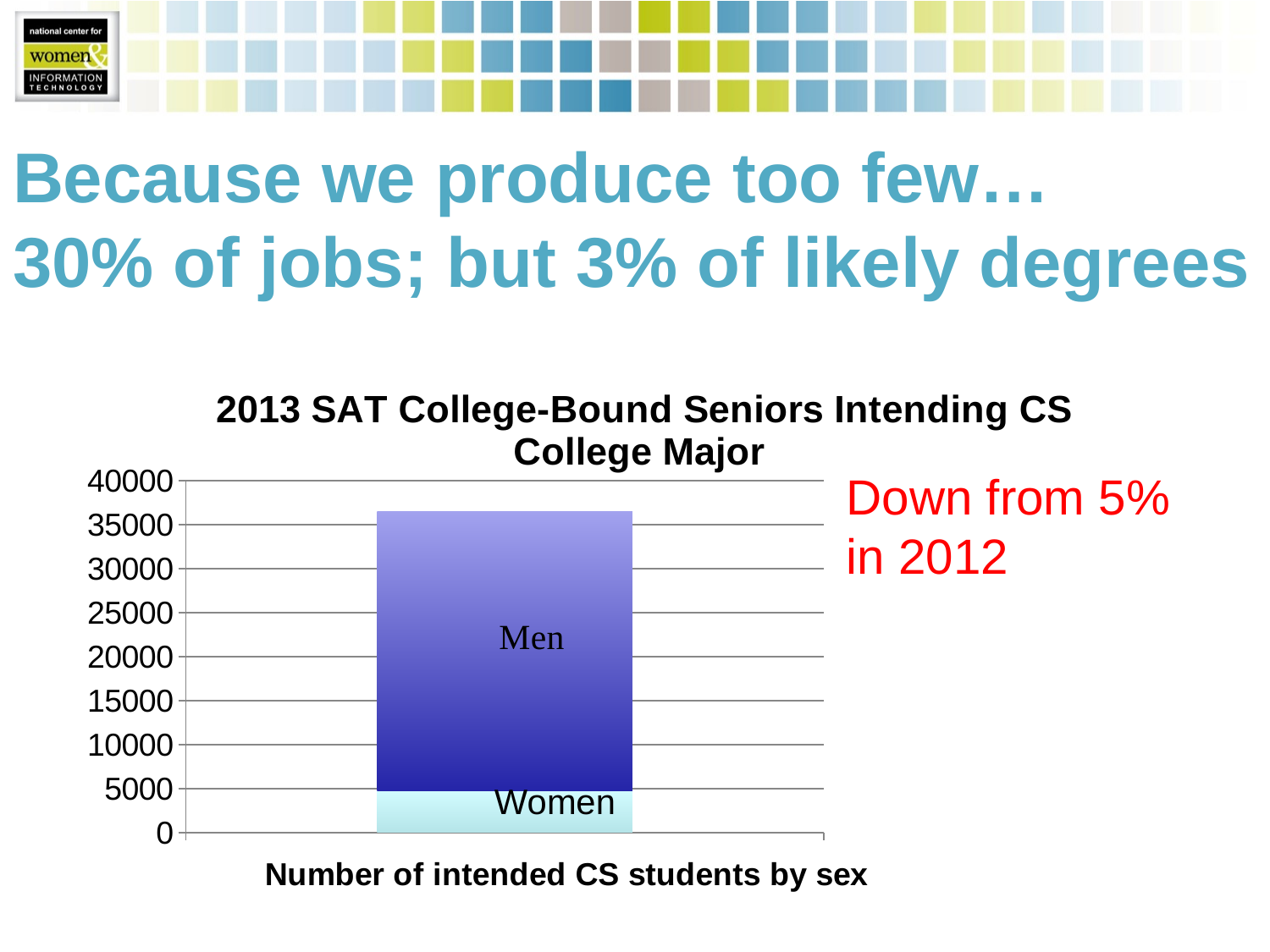
What is the highest value shown on the chart's vertical axis? 40000 How many segments make up the stacked bar in the chart? 2 Which group has the smallest segment in the stacked bar? Women Is the total height of the stacked bar greater or less than 40000? less Is the total height of the stacked bar greater or less than 35000? greater What is the title of the chart? 2013 SAT College-Bound Seniors Intending CS College Major Which segment of the bar is larger, Men or Women? Men How many bars are plotted in the chart? 1 What kind of chart is shown on the slide? stacked bar chart What is the label shown beneath the chart's horizontal axis? Number of intended CS students by sex Which group has the largest segment in the stacked bar? Men